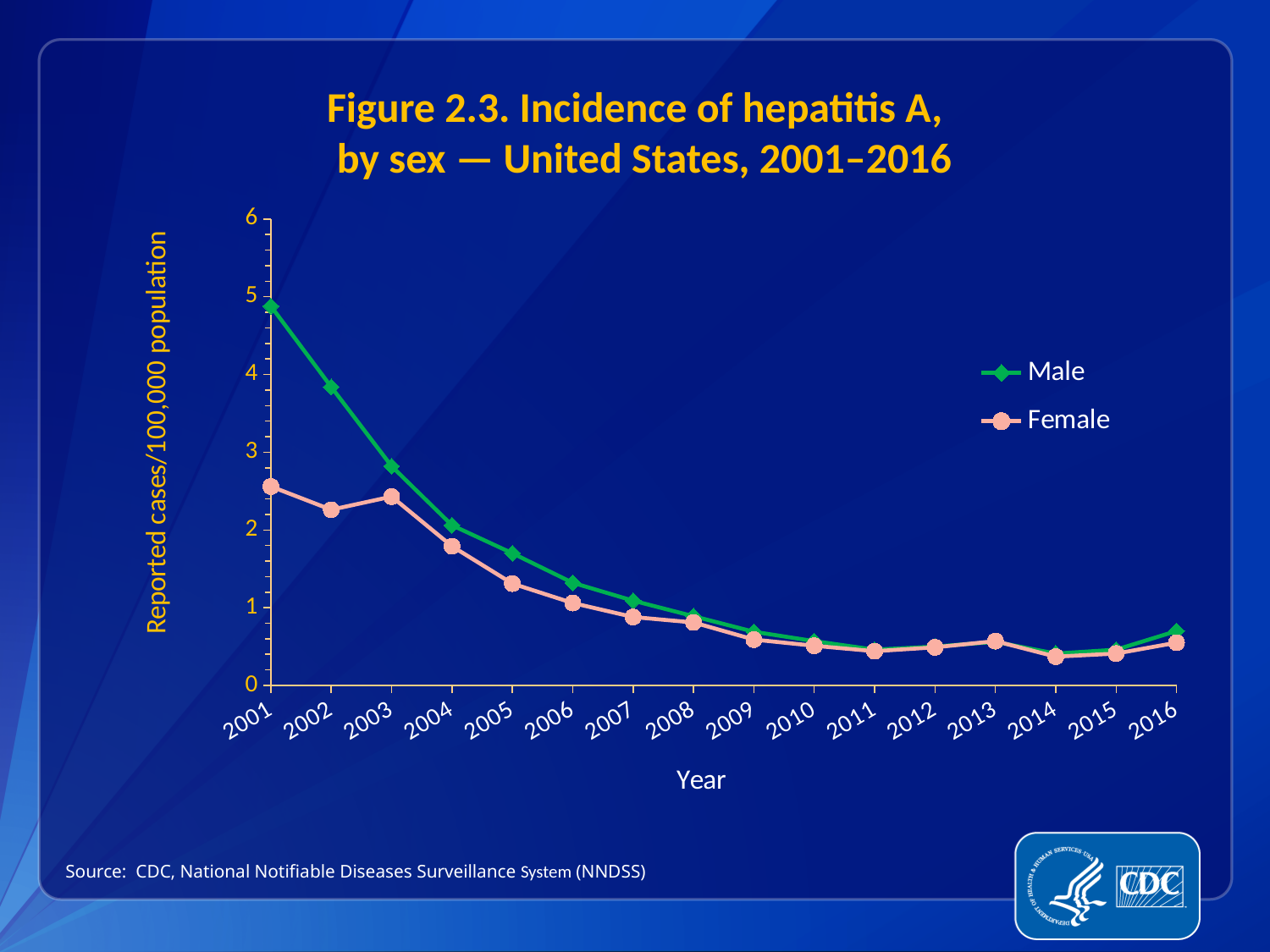
What kind of chart is shown on the slide? line chart What is the label of the y axis? Reported cases/100,000 population How many series does the legend list? 2 In 2003, which series has the higher value, Male or Female? Male How many years are plotted along the x axis? 16 Is the Male value for 2002 greater or less than 3? greater Is the Male value for 2008 greater or less than 1? less Is the Male value for 2001 greater or less than 4? greater In which year is the Male incidence rate highest? 2001 Does the Male incidence rate rise or fall from 2001 to 2010? fall